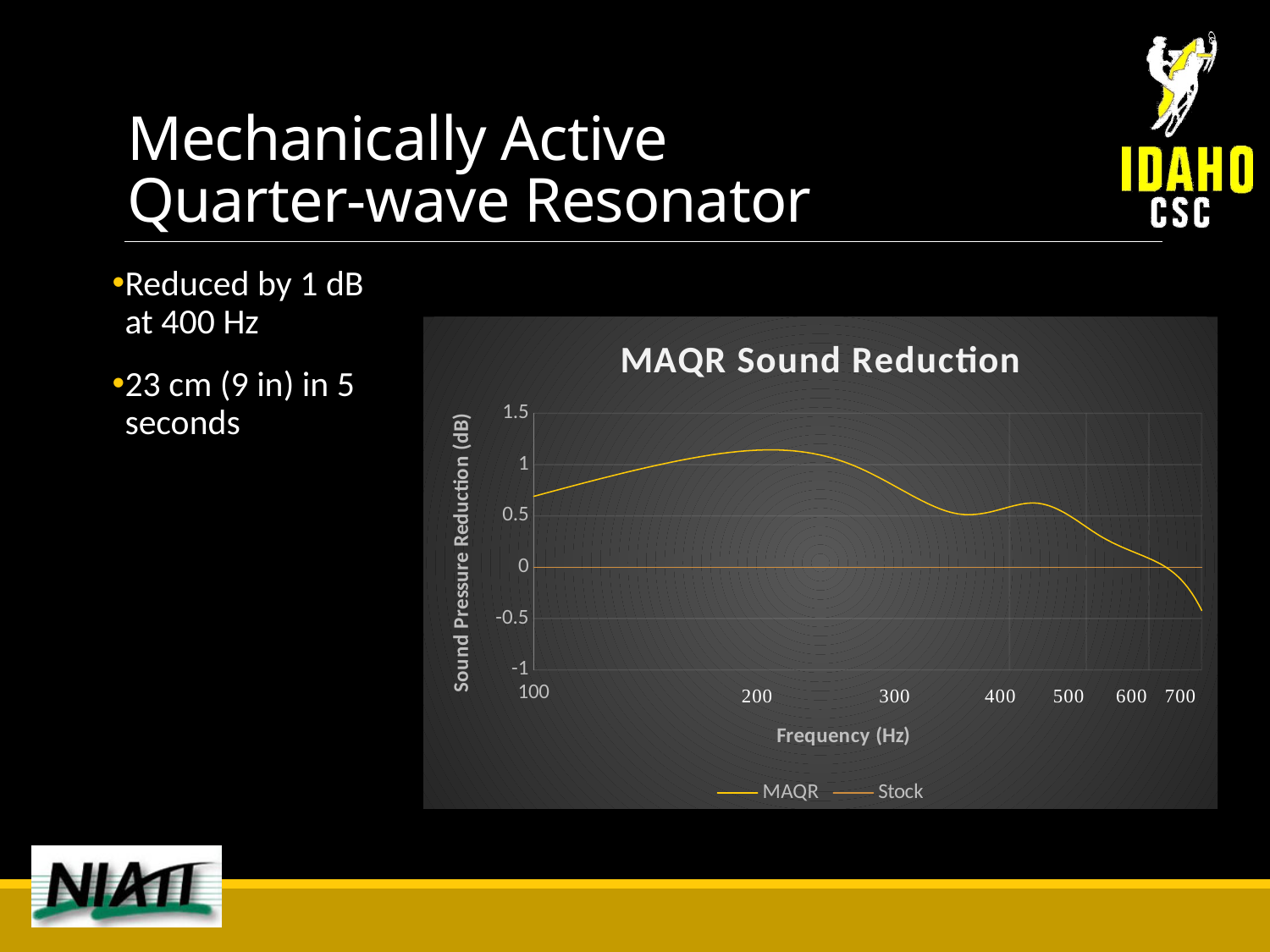
What is the title of the chart? MAQR Sound Reduction Which series is higher at 300 Hz, MAQR or Stock? MAQR Is the MAQR value at 600 Hz greater or less than 0? greater What is the label of the vertical axis of the chart? Sound Pressure Reduction (dB) How many series does the legend of the chart list? 2 What kind of chart is shown on the slide? line chart Is the MAQR value at 400 Hz greater or less than 1? less Is the MAQR value at 100 Hz greater or less than 1? less Which is larger for the MAQR series: the value at 200 Hz or the value at 400 Hz? 200 Hz Does the MAQR line rise or fall between 500 Hz and 700 Hz? fall